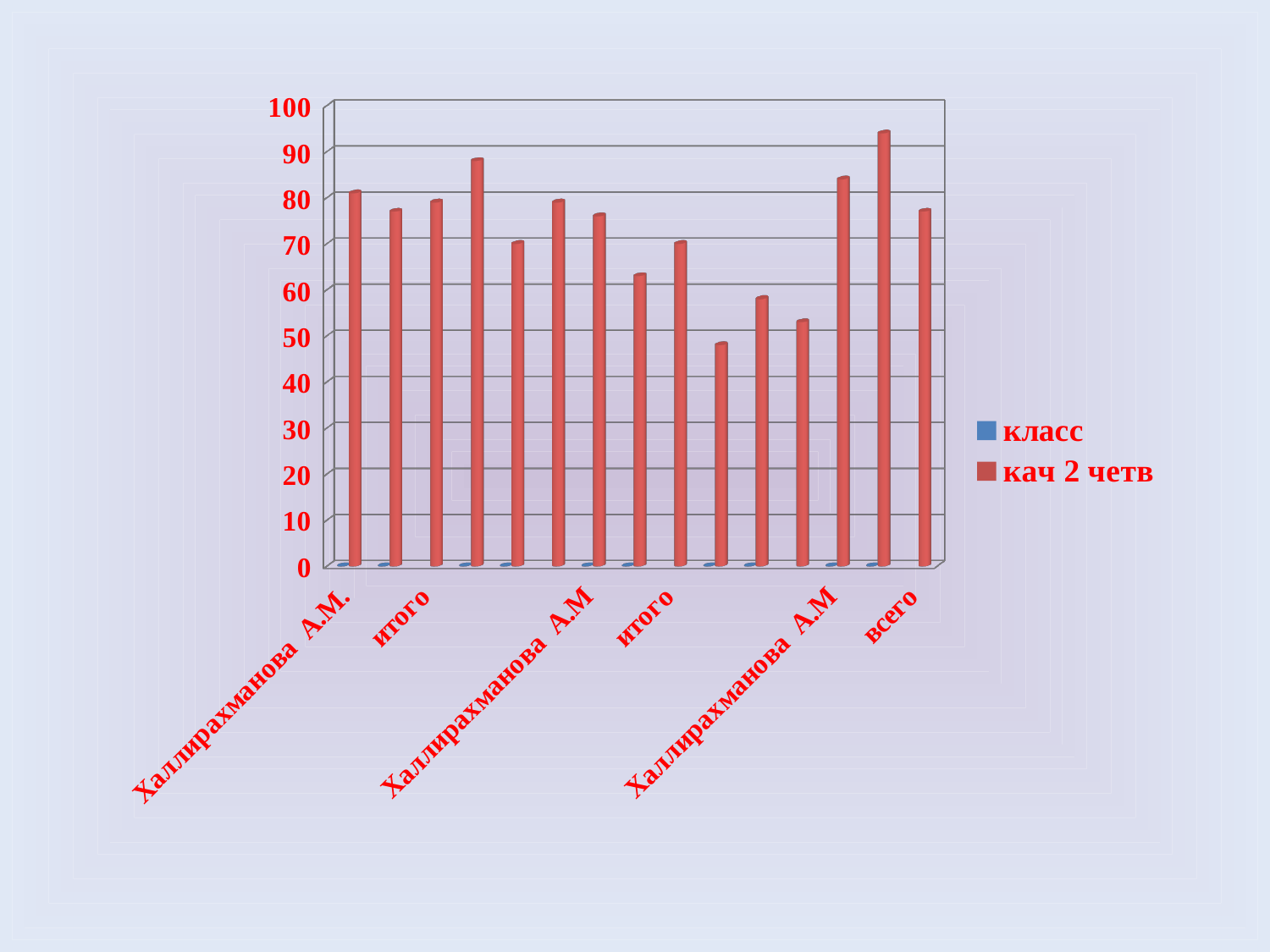
What is the highest value shown on the vertical axis? 100 How many series does the legend list? 2 What kind of chart is shown on the slide? bar chart What colour are the bars for the кач 2 четв series? red Is the tallest кач 2 четв bar greater or less than 90? greater How many red bars (кач 2 четв) are plotted in the chart? 15 What are the two entries in the chart legend? класс, кач 2 четв Is the shortest кач 2 четв bar greater or less than 60? less Are the values of the класс series greater or less than 10? less